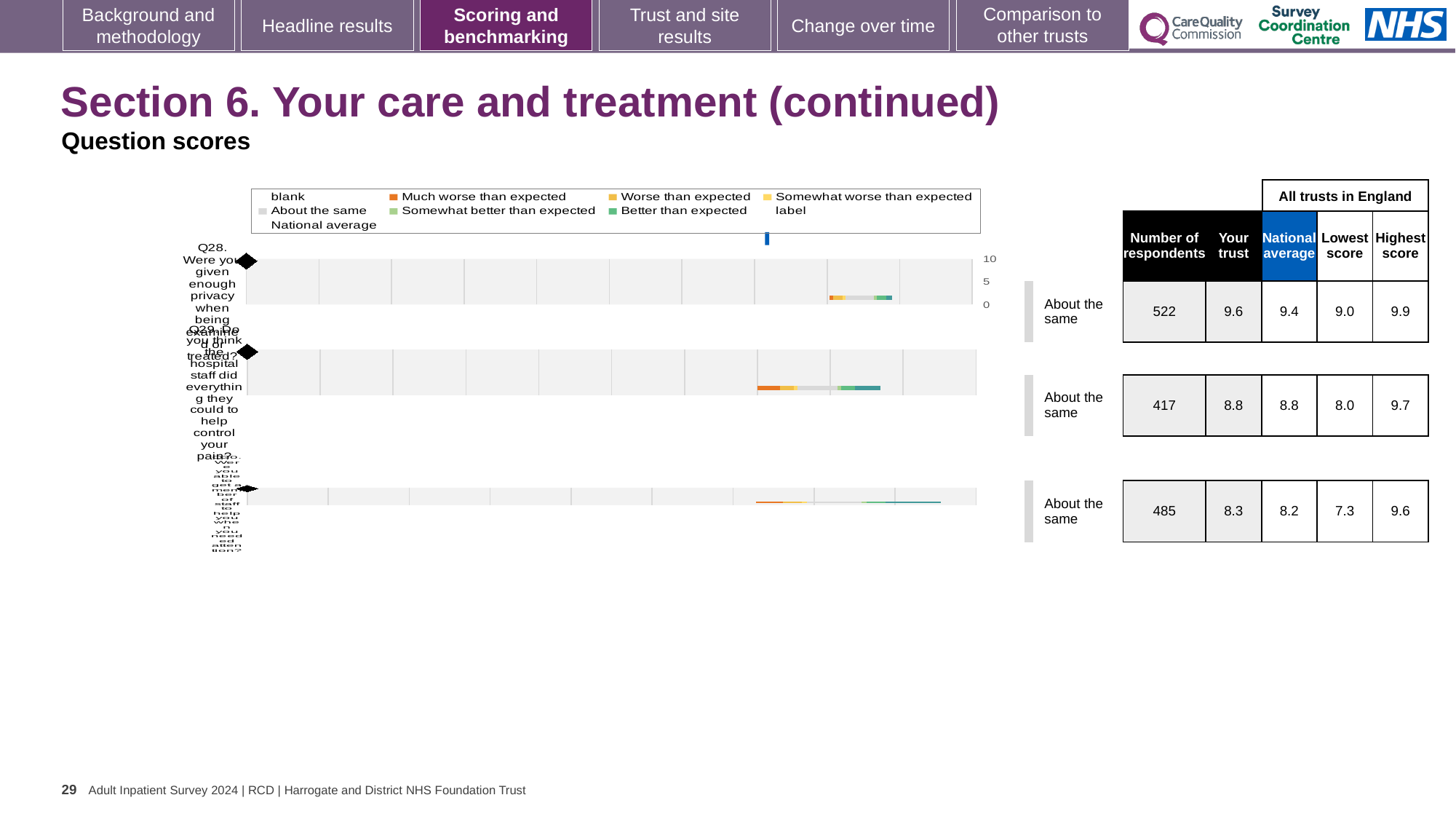
What is the national average score for Q30? 8.2 What is the maximum value shown on the chart's score axis? 10 For Q28, what is the difference between the highest score and the lowest score among all trusts in England? 0.9 How many questions (rows) are plotted in the chart? 3 How many respondents are listed for Q29 (Do you think the hospital staff did everything they could to help control your pain?)? 417 Which question has the lowest 'Lowest score' among all trusts in England? Q30 Is the 'Your trust' value plotted for Q28 greater or less than 5? greater What benchmark category is shown for all three questions on the slide? About the same Which question has the highest 'Your trust' score? Q28 For Q28, is the 'Your trust' score or the national average larger? Your trust What kind of chart is shown on the slide? Bar chart What is the 'Your trust' score for Q28 (Were you given enough privacy when being examined or treated?)? 9.6